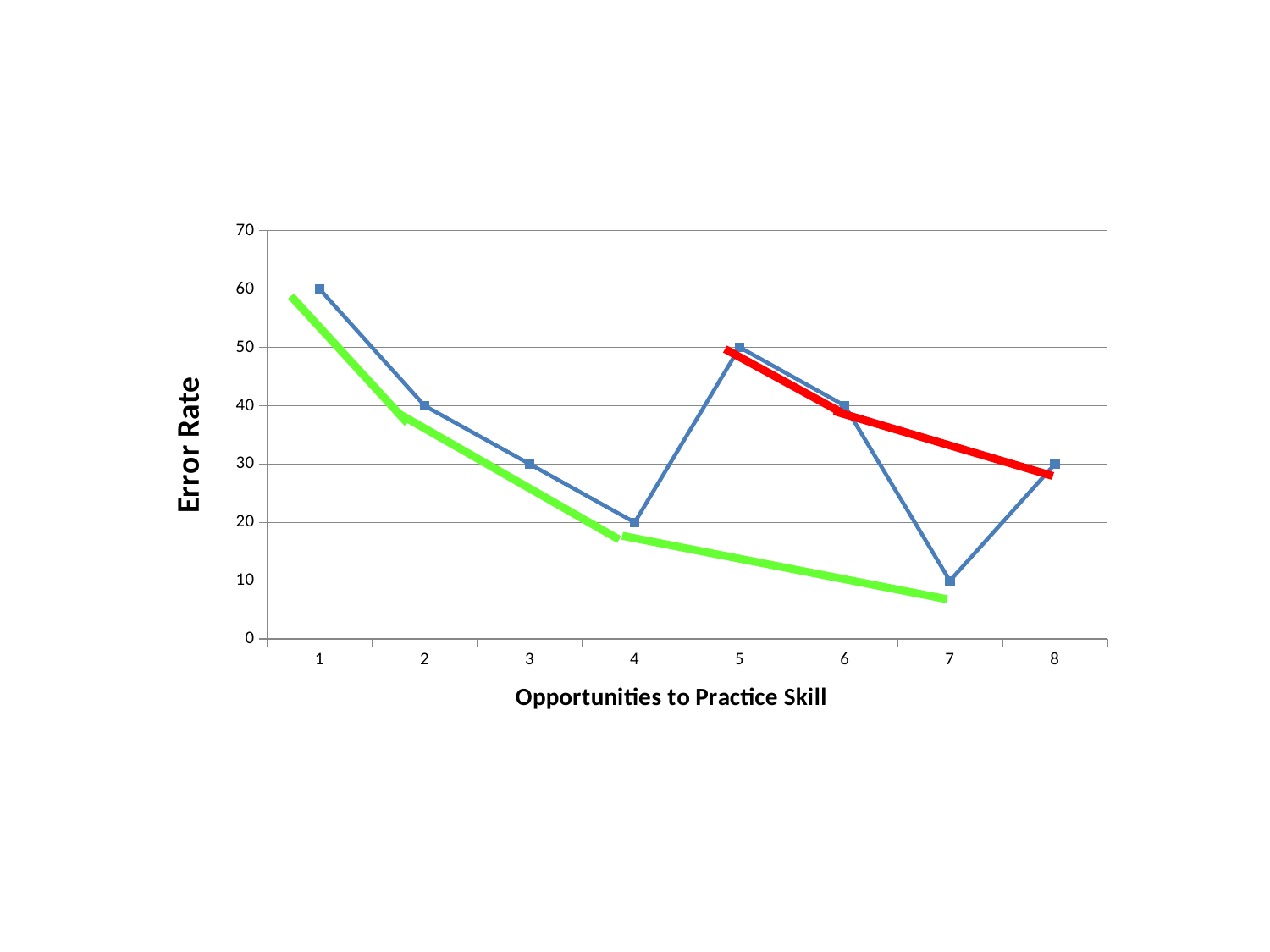
What is the error rate at opportunity 5? 50 What is the error rate at opportunity 1? 60 What is the difference in error rate between opportunity 1 and opportunity 4? 40 What is the label of the y axis? Error Rate At which opportunity is the error rate highest? 1 What is the error rate at opportunity 7? 10 How many opportunities to practice skill are plotted on the x axis? 8 What kind of chart is shown on the slide? line chart Which has a higher error rate, opportunity 5 or opportunity 8? opportunity 5 What is the error rate at opportunity 4? 20 At which opportunity is the error rate lowest? 7 Does the error rate rise or fall from opportunity 1 to opportunity 4? fall